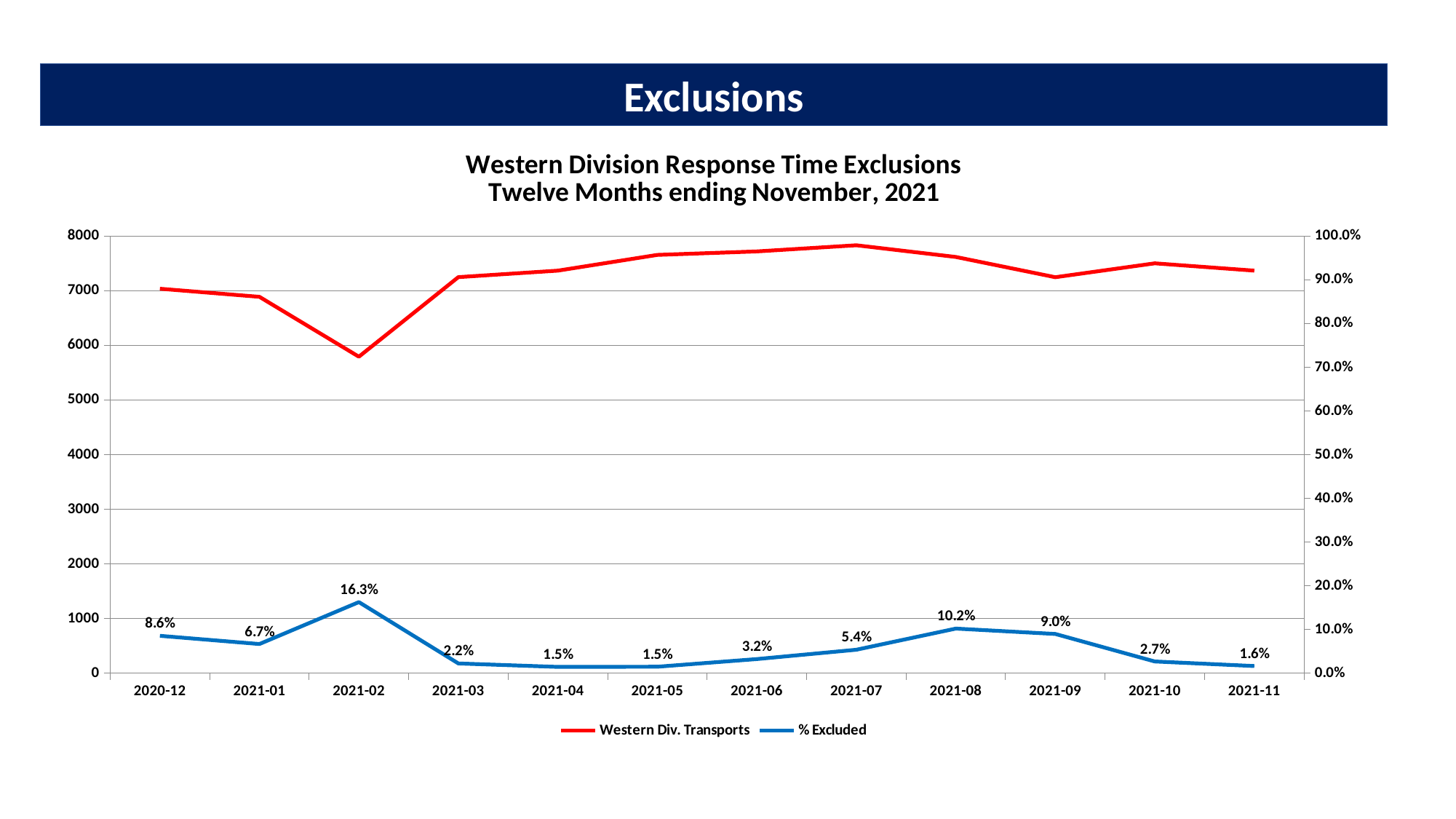
What is the % Excluded value for 2021-02? 16.3% How many series does the legend list? 2 What is the % Excluded value for 2021-11? 1.6% Is the Western Div. Transports value for 2021-02 greater or less than 6000? less What is the % Excluded value for 2021-08? 10.2% What is the difference between the % Excluded values for 2021-02 and 2021-03? 14.1% Which is larger, the % Excluded value for 2021-09 or for 2021-10? 2021-09 How many months are shown on the x axis? 12 Does the % Excluded value rise or fall from 2021-08 to 2021-11? fall What kind of chart is shown on the slide? line chart Is the Western Div. Transports value for 2021-07 greater or less than 7000? greater Which month has the highest % Excluded value? 2021-02